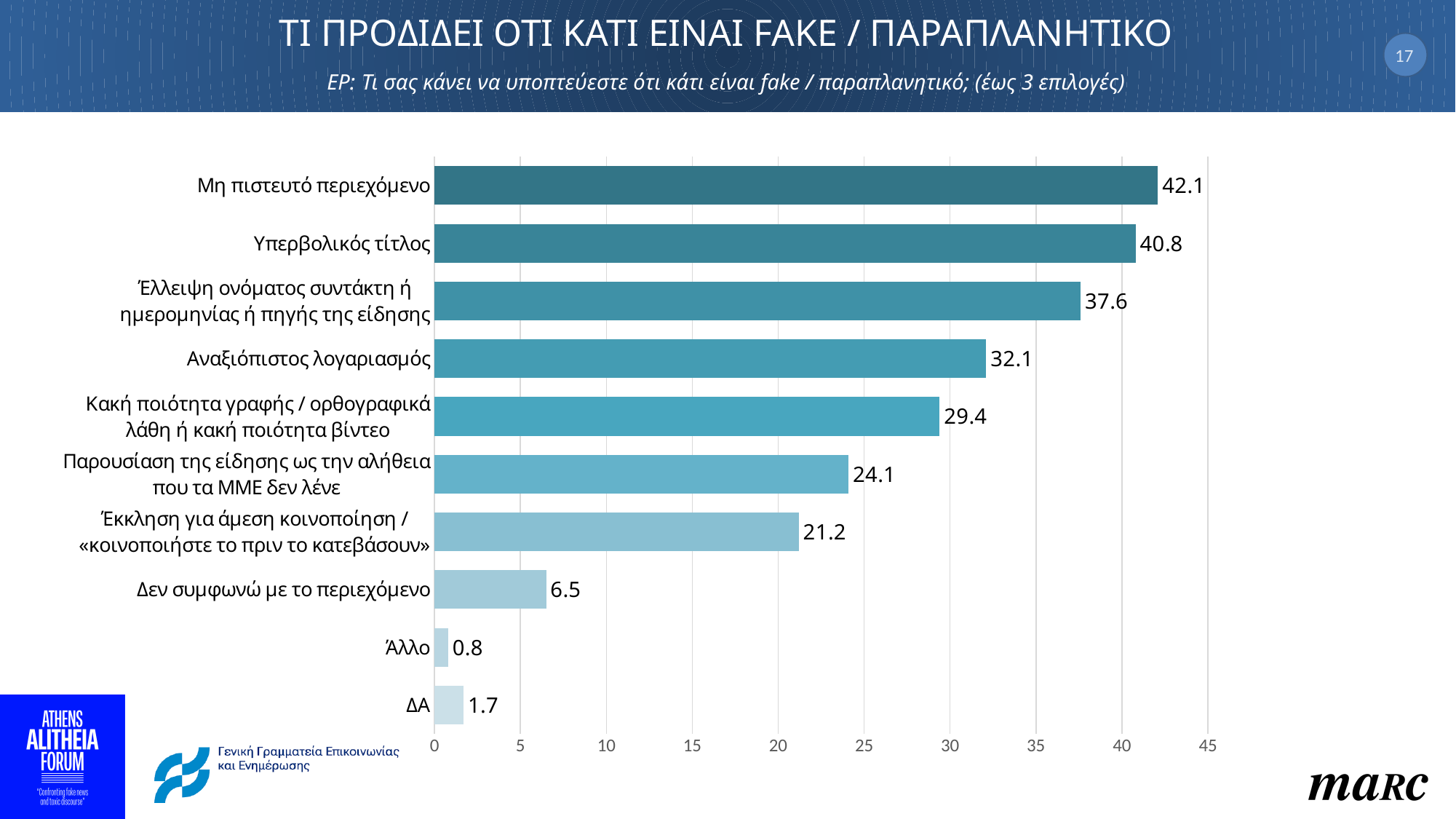
What is the value for Αναξιόπιστος λογαριασμός? 32.1 Which category has the lowest value? Άλλο What is the value for Μη πιστευτό περιεχόμενο? 42.1 What is the difference between the values for Μη πιστευτό περιεχόμενο and Υπερβολικός τίτλος? 1.3 Which is larger: the value for ΔΑ or the value for Άλλο? ΔΑ What is the value for Υπερβολικός τίτλος? 40.8 What is the difference between the values for Αναξιόπιστος λογαριασμός and Δεν συμφωνώ με το περιεχόμενο? 25.6 What kind of chart is shown on the slide? bar chart Which category has the highest value? Μη πιστευτό περιεχόμενο What is the value for Δεν συμφωνώ με το περιεχόμενο? 6.5 How many categories are shown in the chart? 10 Is the value for Έλλειψη ονόματος συντάκτη ή ημερομηνίας ή πηγής της είδησης greater or less than 35? greater